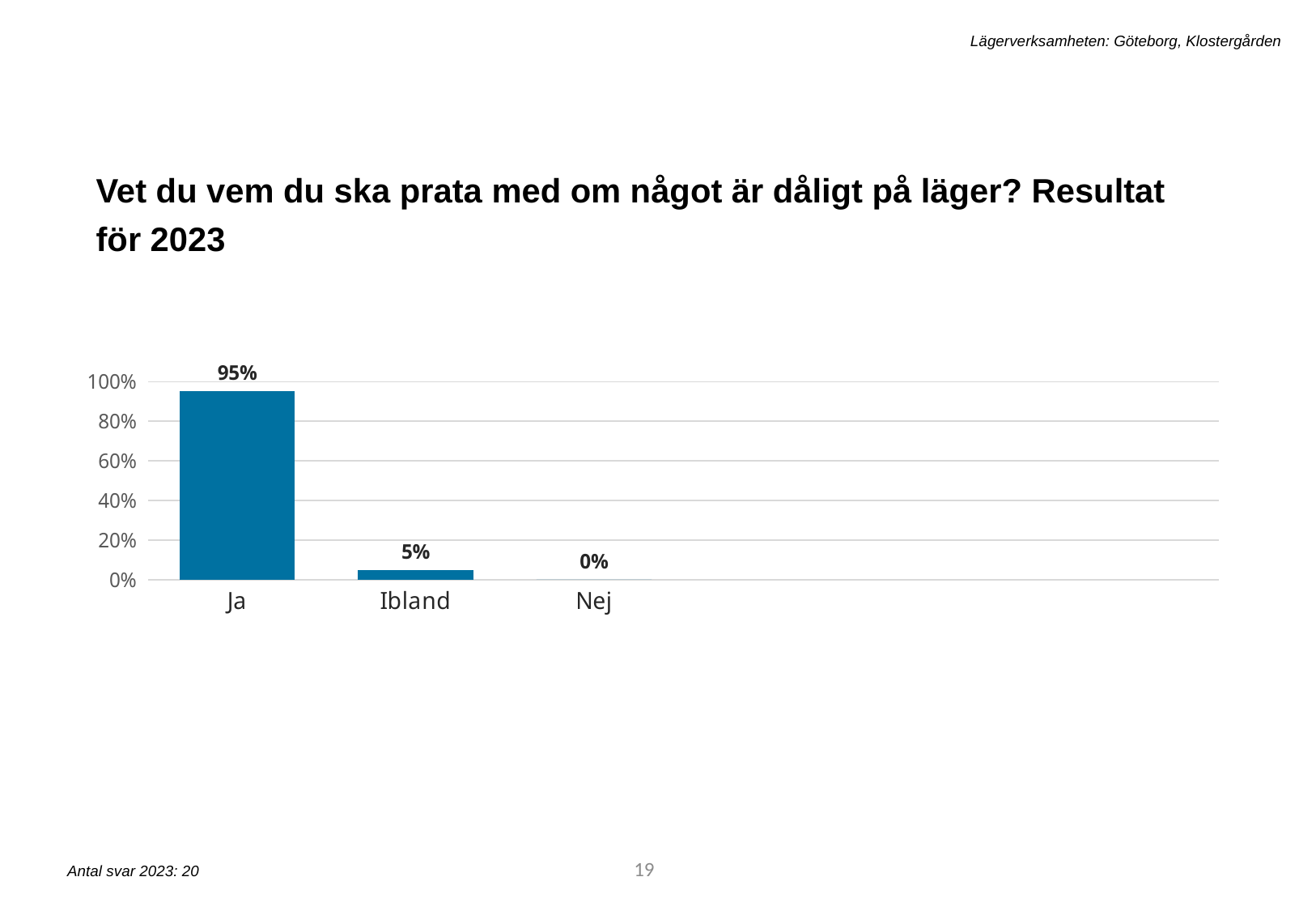
Is the value for Ja greater or less than 80%? greater What is the value for Nej? 0% Which is larger, the value for Ibland or the value for Nej? Ibland What is the difference between the values for Ja and Ibland? 90% What is the value for Ja? 95% Which category has the lowest value? Nej Do the values rise or fall from Ja to Nej along the x axis? fall How many categories are shown on the x axis? 3 Which category has the highest value? Ja What is the value for Ibland? 5% What is the highest tick value shown on the y axis? 100% What kind of chart is shown on the slide? bar chart